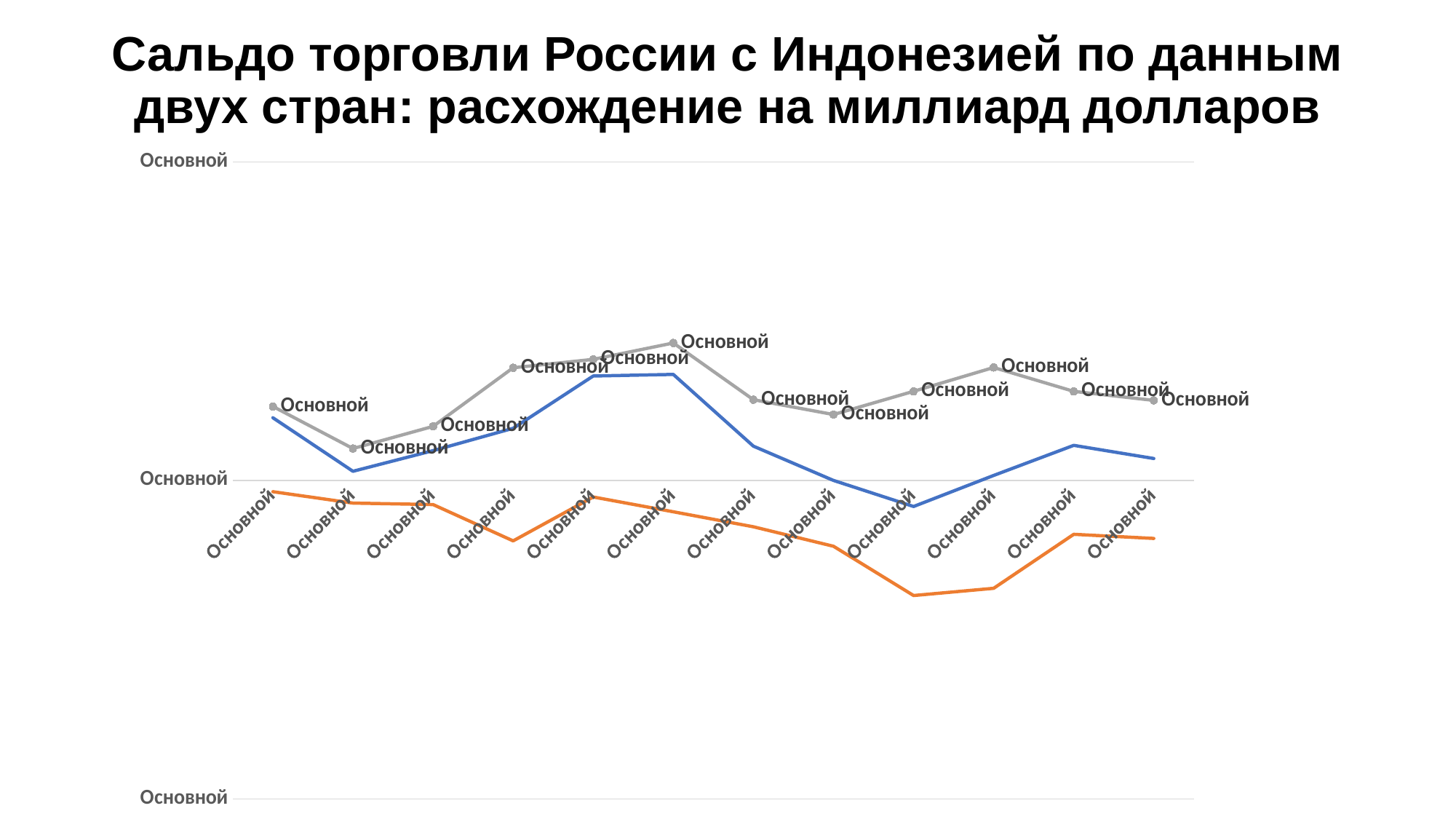
What is the title of the chart on the slide? Сальдо торговли России с Индонезией по данным двух стран: расхождение на миллиард долларов Which line is plotted higher on the chart, the grey line or the blue line? the grey line Which line is plotted lower on the chart, the orange line or the blue line? the orange line Is the last point of the blue line higher or lower than its first point? lower How many lines are plotted on the chart? 3 Is the last point of the orange line higher or lower than its first point? lower Which of the three lines has data labels attached to its points? the grey line How many points (categories) are plotted along the x axis of the chart? 12 What kind of chart is shown on the slide? line chart